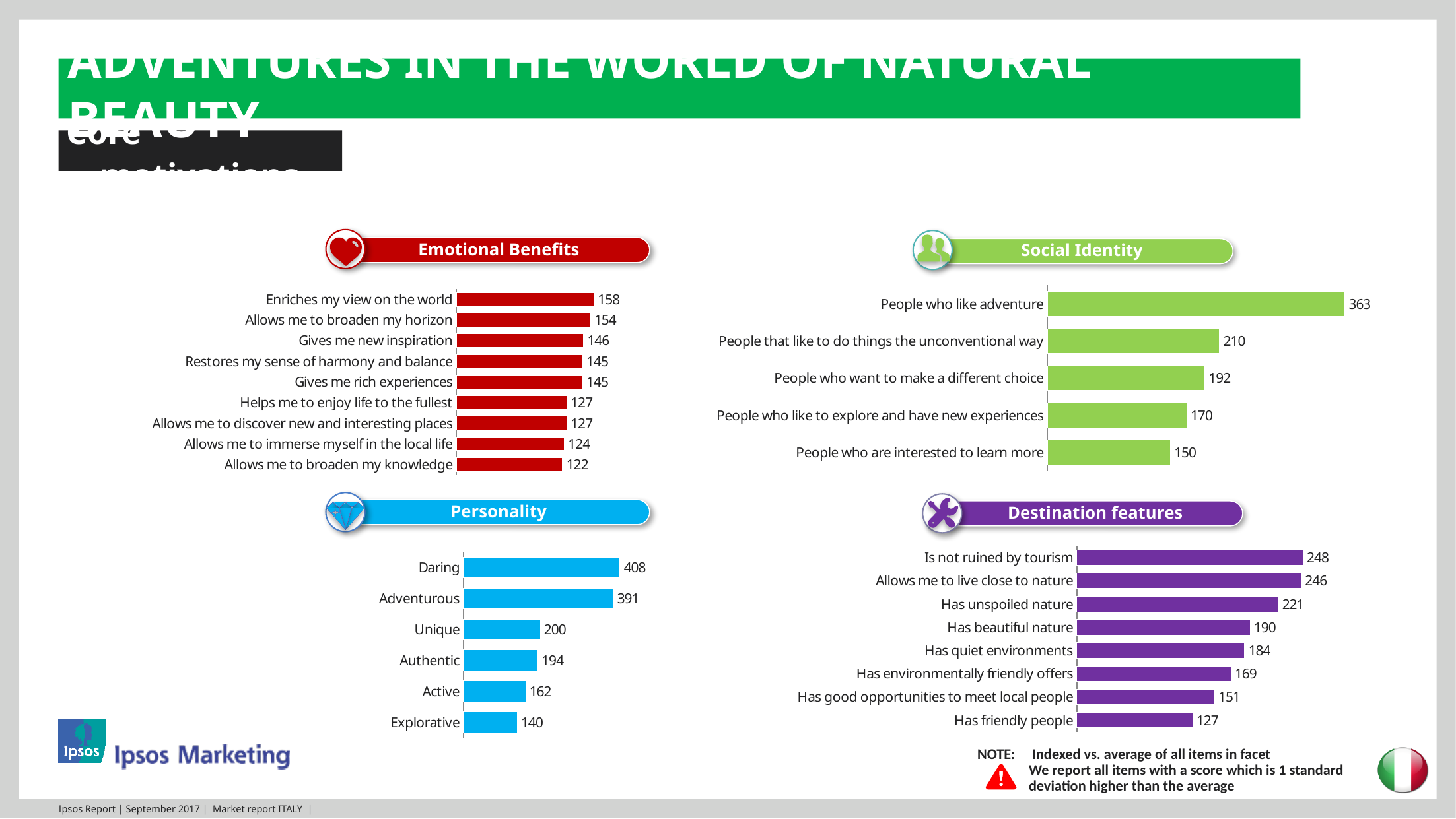
How many categories are shown in the Social Identity chart? 5 In the Emotional Benefits chart, which category has the lowest value? Allows me to broaden my knowledge In the Social Identity chart, what is the value for "People who like adventure"? 363 In the Emotional Benefits chart, which category has the highest value? Enriches my view on the world In the Social Identity chart, what is the difference between "People who like adventure" and "People that like to do things the unconventional way"? 153 In the Emotional Benefits chart, what is the value for "Gives me new inspiration"? 146 In the Personality chart, which is larger, "Unique" or "Active"? Unique In the Personality chart, what is the value for "Authentic"? 194 How many categories are shown in the Destination features chart? 8 What type of chart is the Destination features chart? Bar chart In the Personality chart, which category has the lowest value? Explorative In the Destination features chart, what is the value for "Has quiet environments"? 184